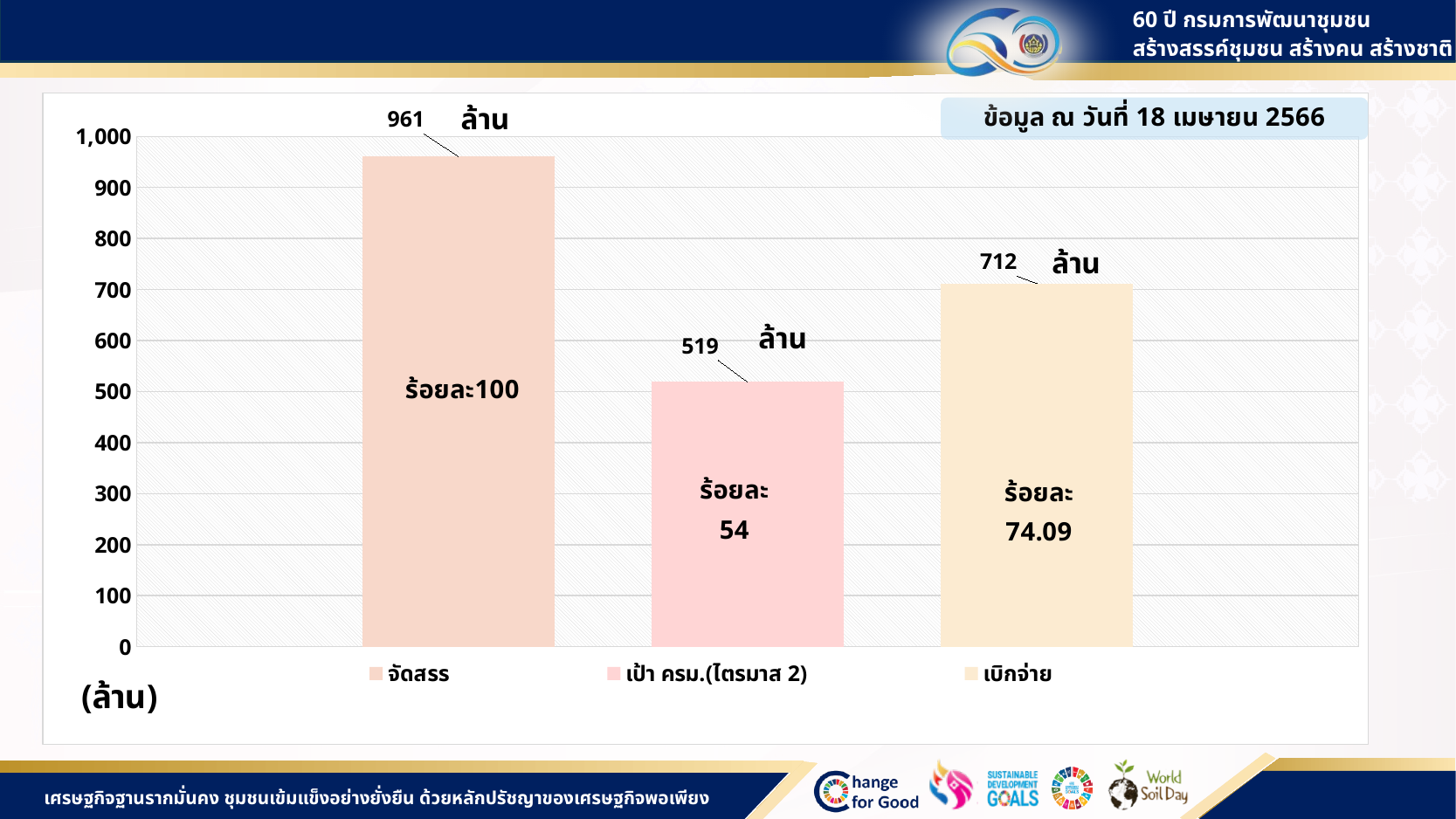
What is the value for เบิกจ่าย? 712 Which is larger, the value for เบิกจ่าย or the value for เป้า ครม.(ไตรมาส 2)? เบิกจ่าย What percentage (ร้อยละ) is shown inside the เบิกจ่าย bar? 74.09 What percentage (ร้อยละ) is shown inside the เป้า ครม.(ไตรมาส 2) bar? 54 What is the value for เป้า ครม.(ไตรมาส 2)? 519 Which category has the highest value? จัดสรร Which category has the lowest value? เป้า ครม.(ไตรมาส 2) What is the value for จัดสรร? 961 What is the difference between the values for จัดสรร and เบิกจ่าย? 249 What kind of chart is shown on the slide? Bar chart How many bars are plotted in the chart? 3 What unit is shown in the bottom-left corner of the chart? (ล้าน)